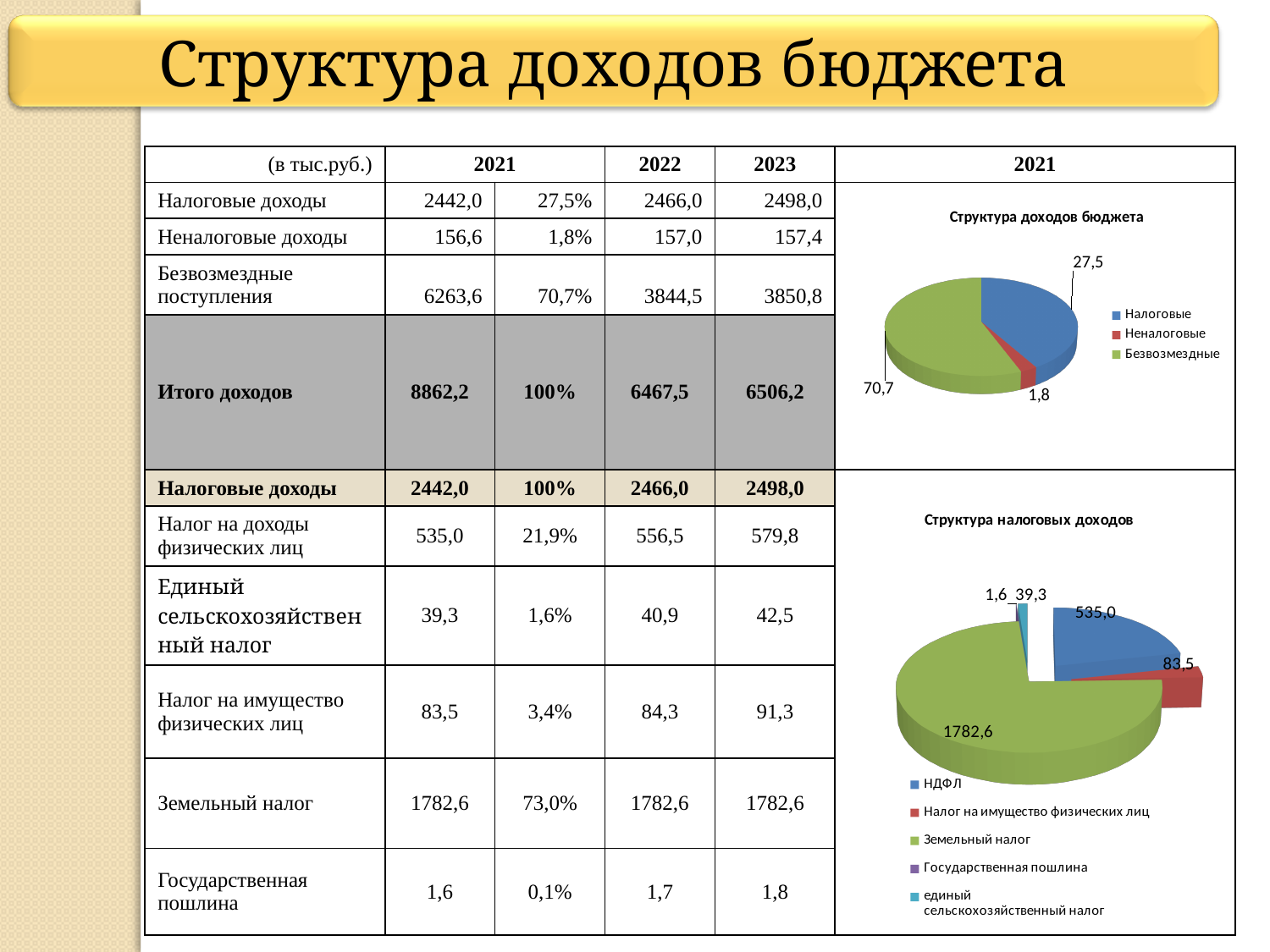
На диаграмме «Структура доходов бюджета» какое значение указано для сегмента «Налоговые»? 27,5 На диаграмме «Структура доходов бюджета» какой сегмент самый большой? Безвозмездные Какого типа диаграмма «Структура доходов бюджета»? Круговая диаграмма На диаграмме «Структура доходов бюджета» какое значение указано для сегмента «Безвозмездные»? 70,7 На диаграмме «Структура доходов бюджета» какой сегмент самый маленький? Неналоговые На диаграмме «Структура налоговых доходов» какое значение указано для сегмента «Земельный налог»? 1782,6 Сколько категорий перечислено в легенде диаграммы «Структура налоговых доходов»? 5 На диаграмме «Структура налоговых доходов» какое значение указано для сегмента «Налог на имущество физических лиц»? 83,5 Сколько категорий перечислено в легенде диаграммы «Структура доходов бюджета»? 3 На диаграмме «Структура налоговых доходов» на сколько значение «Земельный налог» больше значения «НДФЛ»? 1247,6 На диаграмме «Структура налоговых доходов» какой сегмент самый большой? Земельный налог На диаграмме «Структура налоговых доходов» какое значение указано для сегмента «НДФЛ»? 535,0